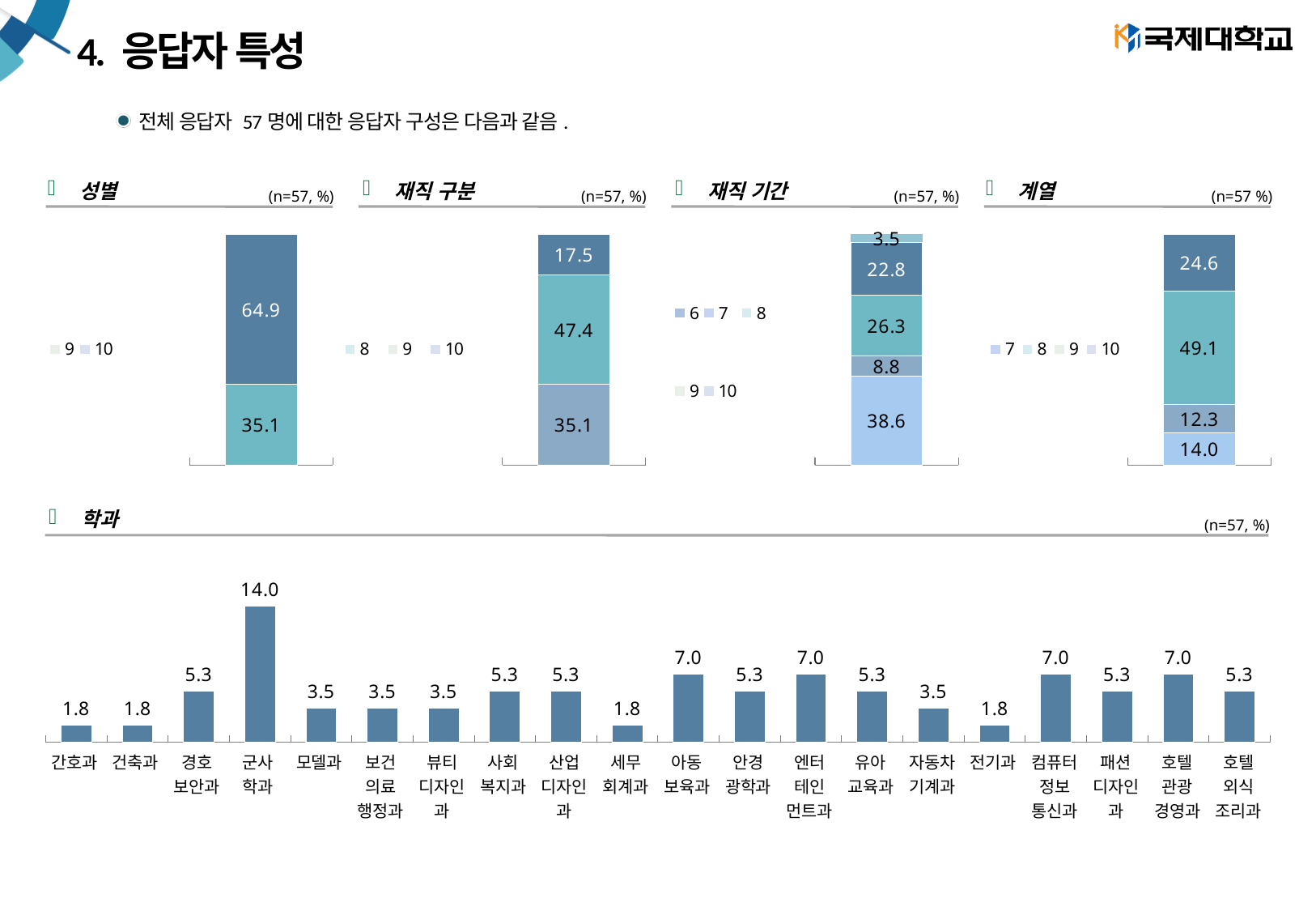
In the 학과 chart, what is the value for 군사학과? 14.0 In the 학과 chart, which is larger, the value for 아동보육과 or 안경광학과? 아동보육과 In the 계열 chart, what is the total of the stacked bar? 100.0 In the 학과 chart, what is the difference between the values for 군사학과 and 경호보안과? 8.7 In the 학과 chart, how many departments are shown? 20 What kind of chart is the 학과 chart? bar chart In the 계열 chart, what is the value of the bottom segment of the stacked bar? 14.0 In the 재직 구분 chart, what is the value of the middle segment of the stacked bar? 47.4 In the 성별 chart, what is the value of the top segment of the stacked bar? 64.9 In the 학과 chart, which department has the highest value? 군사학과 In the 재직 기간 chart, what is the value of the largest segment of the stacked bar? 38.6 In the 학과 chart, what is the value for 컴퓨터정보통신과? 7.0